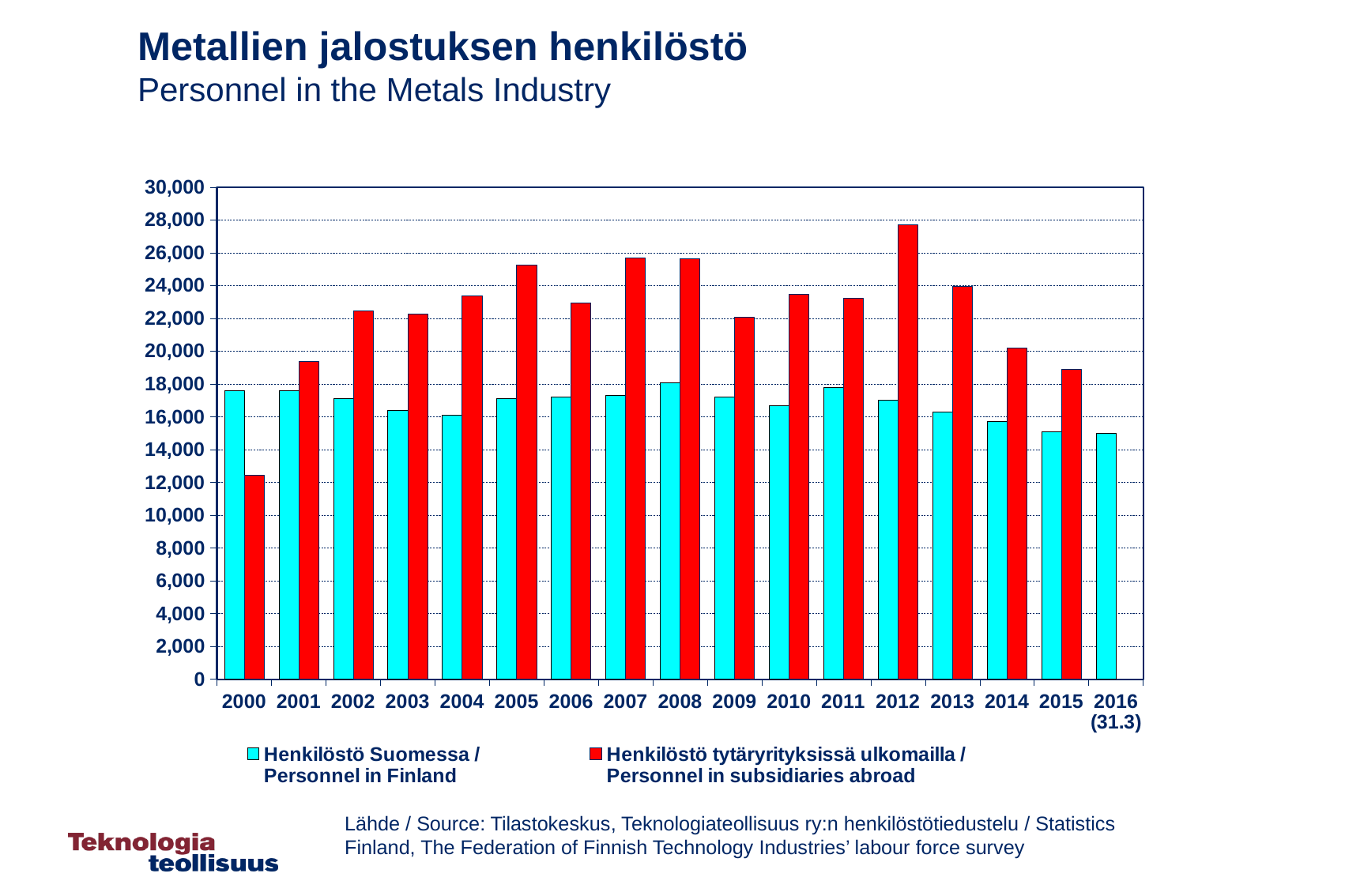
In 2000, which is larger: Personnel in Finland or Personnel in subsidiaries abroad? Personnel in Finland Is the value for Personnel in Finland in 2016 (31.3) greater or less than 16,000? less How many years are shown on the x axis? 17 What kind of chart is shown on the slide? bar chart Is the value for Personnel in subsidiaries abroad in 2015 greater or less than 20,000? less How many series does the legend list? 2 Which is larger: Personnel in subsidiaries abroad in 2007 or in 2009? 2007 Is the value for Personnel in subsidiaries abroad in 2012 greater or less than 26,000? greater In which year is the value for Personnel in subsidiaries abroad highest? 2012 In which year is the value for Personnel in subsidiaries abroad lowest? 2000 Does the value for Personnel in Finland rise or fall from 2011 to 2016 (31.3)? fall